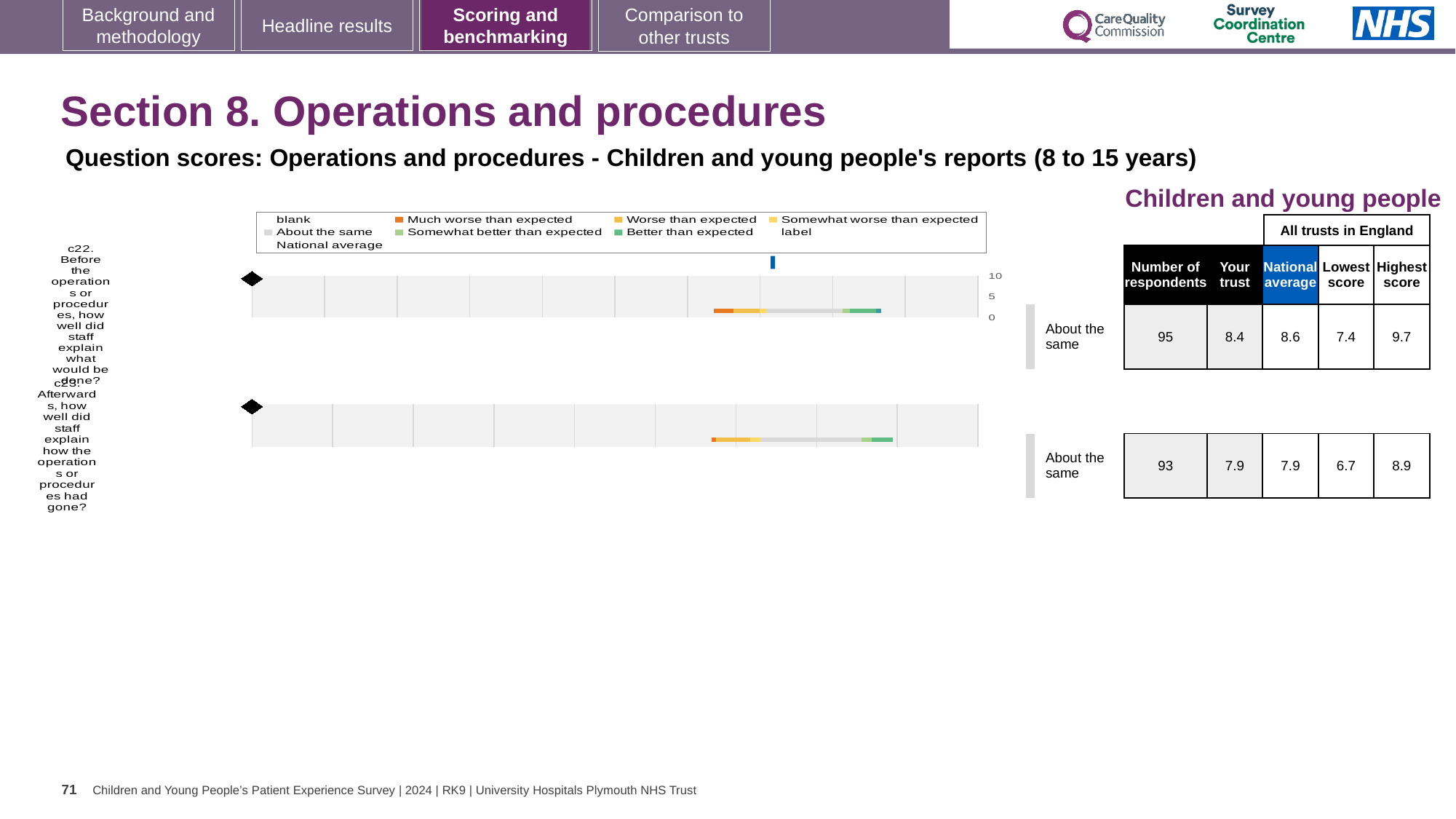
How many respondents answered question c23? 93 What is the difference between the highest and lowest scores across all trusts in England for question c23? 2.2 What is the 'Your trust' score for question c23 (Afterwards, how well did staff explain how the operations or procedures had gone?)? 7.9 How many survey questions are plotted in the chart on this slide? 2 What kind of chart is used to show the question scores on this slide? Bar chart For question c22, which is larger: the trust's score or the national average? National average What benchmarking category is shown for question c23? About the same Which of the two questions has the higher 'Your trust' score? c22 What is the highest score across all trusts in England for question c22? 9.7 What is the 'Your trust' score for question c22 (Before the operations or procedures, how well did staff explain what would be done?)? 8.4 What is the national average score for question c22? 8.6 In the legend, what colour represents 'Much worse than expected'? Orange